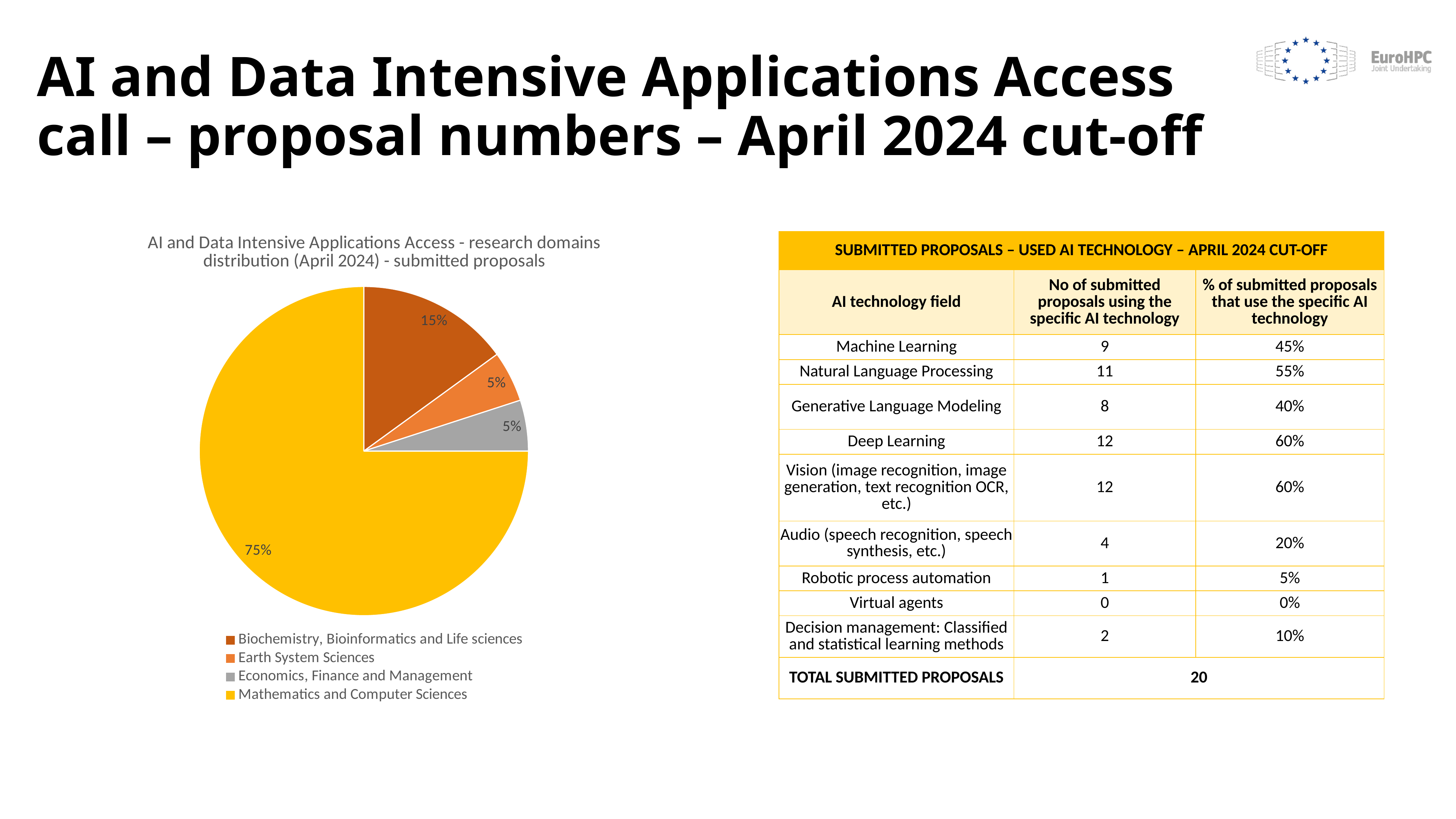
What colour is the Mathematics and Computer Sciences slice in the pie chart? Yellow Which research domain has the largest slice in the pie chart? Mathematics and Computer Sciences In the pie chart, what share of submitted proposals is in Economics, Finance and Management? 5% What is the title of the pie chart? AI and Data Intensive Applications Access - research domains distribution (April 2024) - submitted proposals How many research domains are shown in the pie chart? 4 In the pie chart, what share of submitted proposals is in Biochemistry, Bioinformatics and Life sciences? 15% In the pie chart, what share of submitted proposals is in Earth System Sciences? 5% What type of chart is shown on the left of the slide? Pie chart In the pie chart, what is the difference in percentage points between Mathematics and Computer Sciences and Biochemistry, Bioinformatics and Life sciences? 60 percentage points In the pie chart, which is larger: the share for Biochemistry, Bioinformatics and Life sciences or the share for Earth System Sciences? Biochemistry, Bioinformatics and Life sciences In the pie chart, what is the combined share of Earth System Sciences and Economics, Finance and Management? 10%